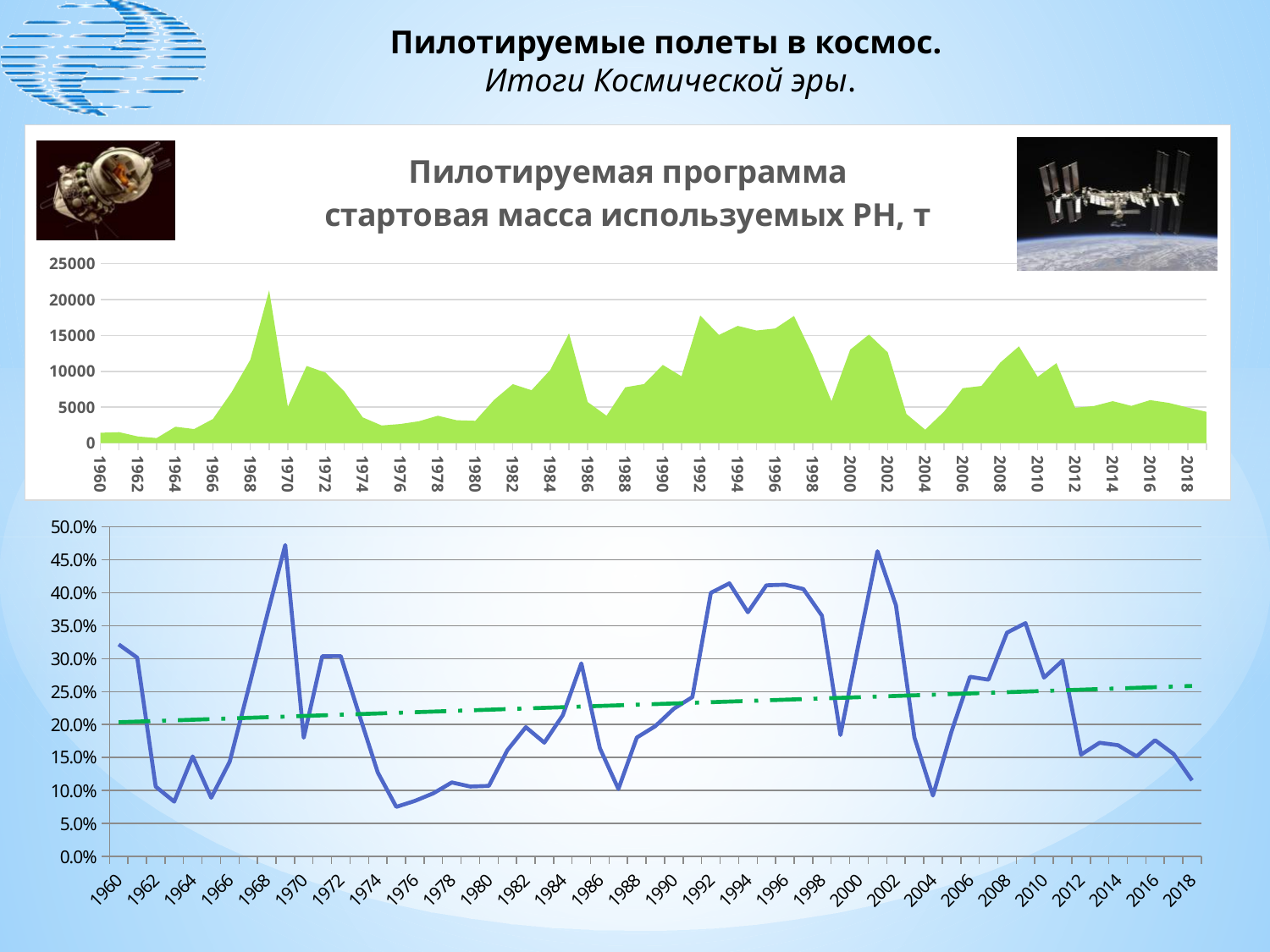
In the bottom chart with the percentage axis, does the green dashed trend line rise or fall from 1960 to 2018? rise In the bottom chart with the percentage axis, is the value of the blue line for 2018 greater or less than 15.0%? less In the bottom chart with the percentage axis, is the value of the blue line for 1975 greater or less than 10.0%? less What kind of chart is the top chart titled 'Пилотируемая программа стартовая масса используемых РН, т'? area chart What kind of chart is the bottom chart with the percentage axis? line chart In the top chart 'Пилотируемая программа стартовая масса используемых РН, т', is the value for 1969 greater or less than 15000? greater In the bottom chart with the percentage axis, which year has the lowest value of the solid blue line? 1975 In the top chart 'Пилотируемая программа стартовая масса используемых РН, т', which is larger, the value for 1969 or the value for 1985? 1969 In the top chart 'Пилотируемая программа стартовая масса используемых РН, т', which year has the highest value? 1969